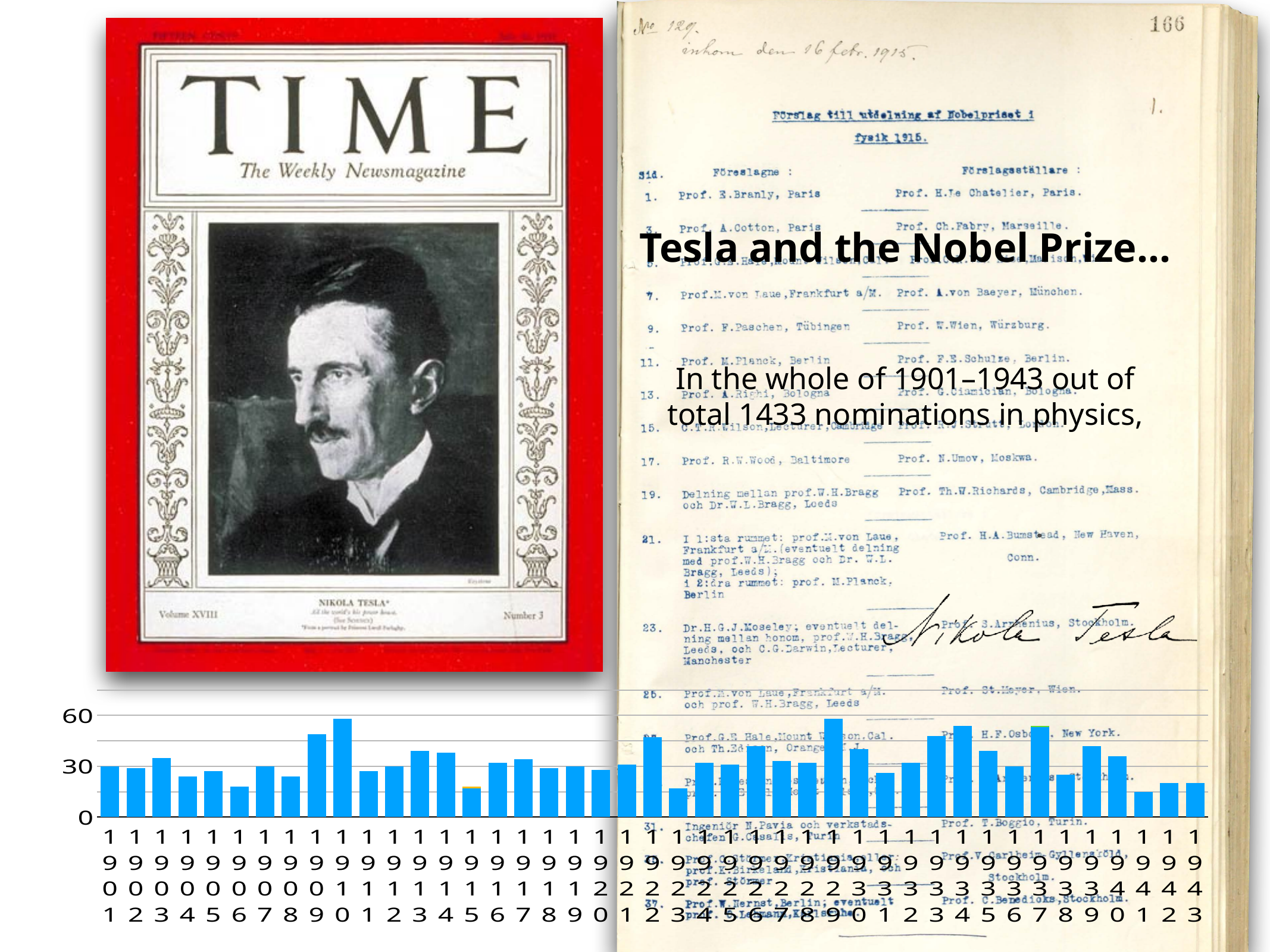
Is the value for 1906 greater or less than 30? less Which has the larger value, 1910 or 1906? 1910 Which has the larger value, 1909 or 1908? 1909 What kind of chart is shown at the bottom of the slide? bar chart What is the first year shown on the x axis of the bar chart? 1901 How many years (categories) are plotted along the x axis of the bar chart? 43 Is the value for 1909 greater or less than 30? greater What is the highest tick value shown on the y axis of the bar chart? 60 Is the value for 1913 greater or less than 30? greater